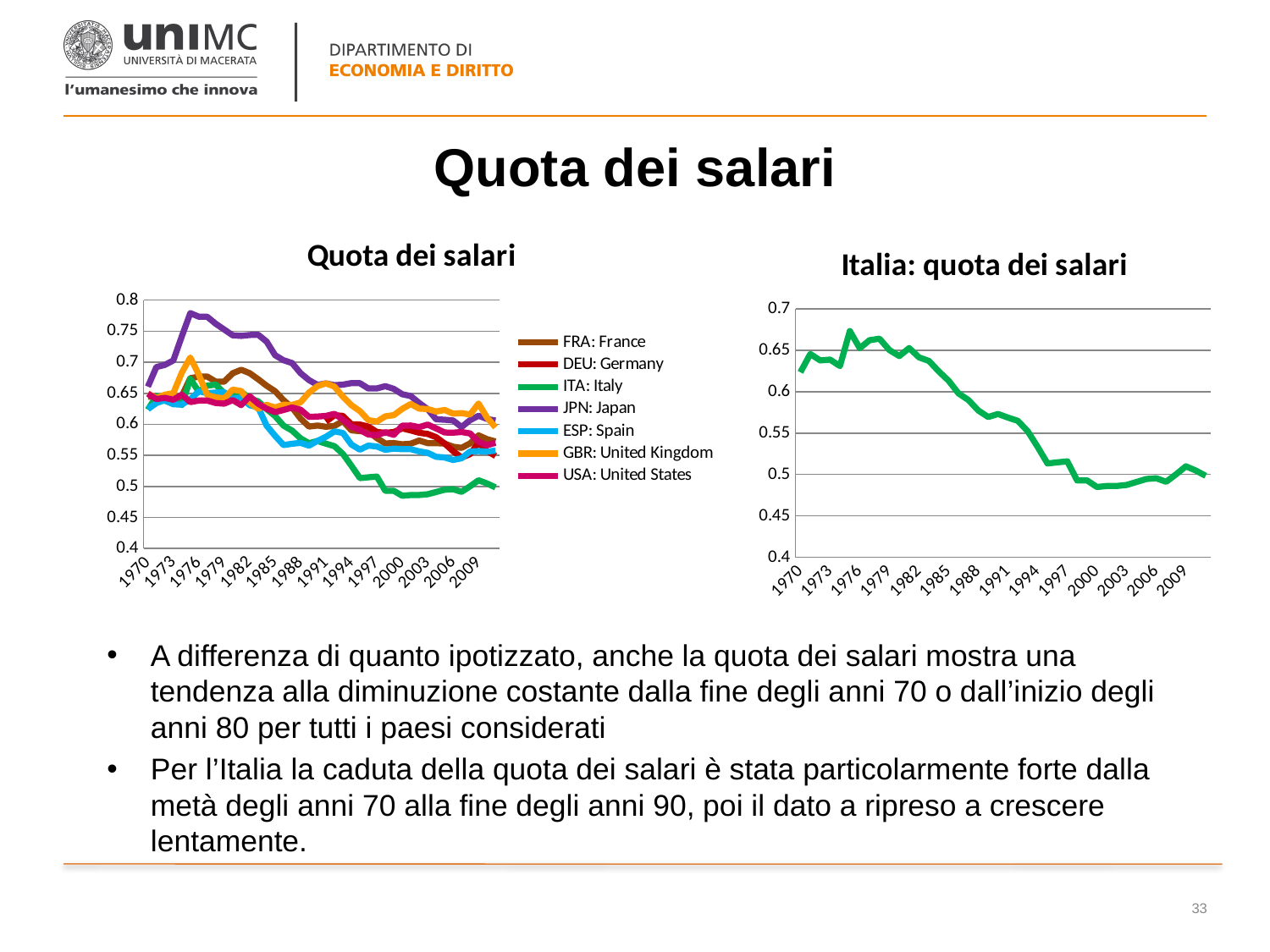
How many series does the legend of the left chart "Quota dei salari" list? 7 What kind of chart is the left chart titled "Quota dei salari"? line chart In the left chart "Quota dei salari", is the value for ITA: Italy in 2000 greater or less than 0.5? less What is the title of the right chart? Italia: quota dei salari In the right chart "Italia: quota dei salari", does the series overall rise or fall from 1970 to 2009? fall In the left chart "Quota dei salari", does the JPN: Japan series rise or fall from 1976 to 2009? fall In the left chart "Quota dei salari", which country's series reaches the highest value around 1976? JPN: Japan In the right chart "Italia: quota dei salari", is the value in 2000 greater or less than 0.5? less In the left chart "Quota dei salari", which country's series is the lowest around 2000? ITA: Italy In the left chart "Quota dei salari", is the value for JPN: Japan in 1976 greater or less than 0.75? greater In the left chart "Quota dei salari", what colour is the line for ITA: Italy? green